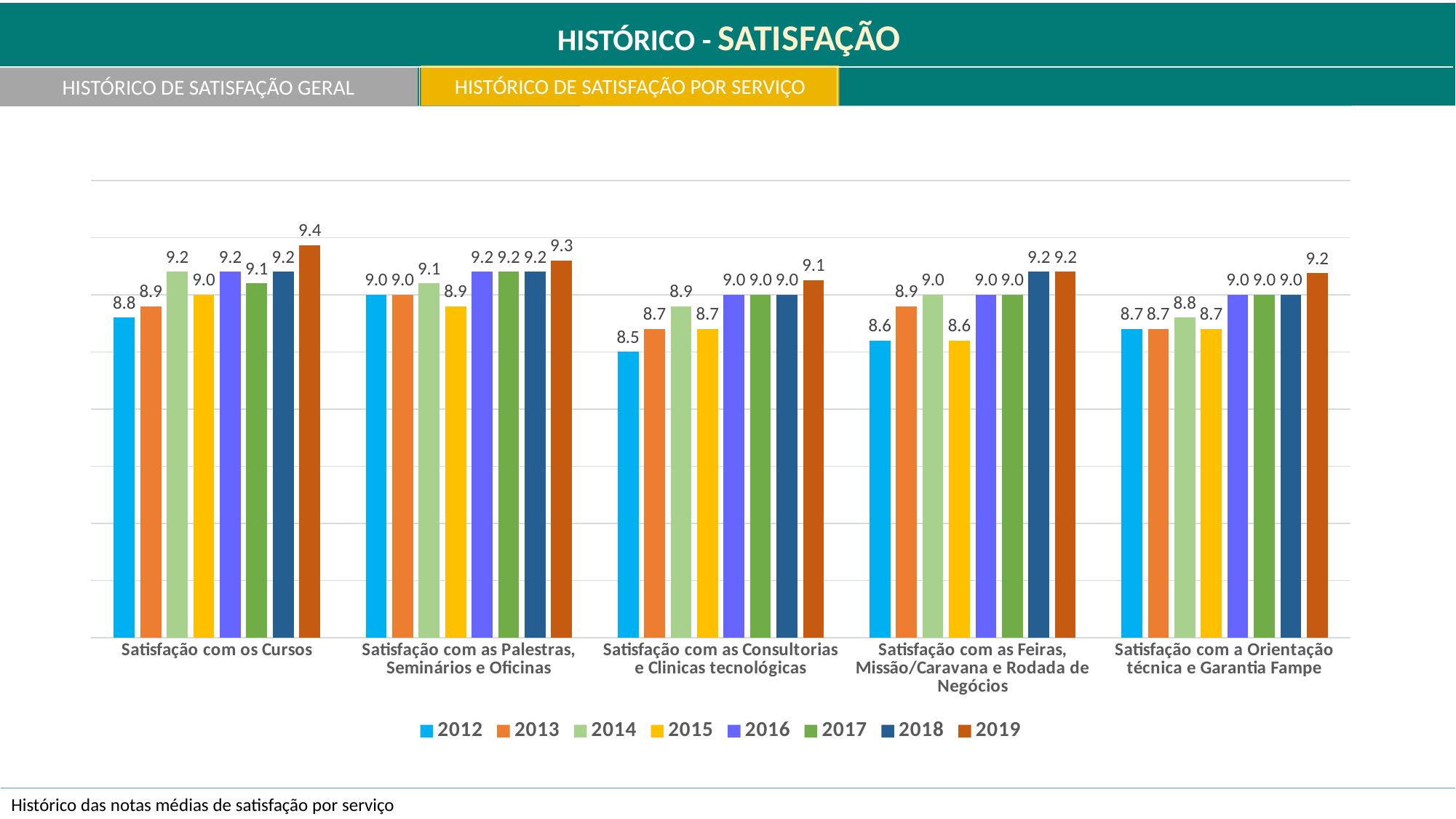
What is the 2019 value for Satisfação com os Cursos? 9.4 What is the 2014 value for Satisfação com a Orientação técnica e Garantia Fampe? 8.8 Which year is shown in the legend with a yellow colour? 2015 Which is larger for 2013: Satisfação com as Feiras, Missão/Caravana e Rodada de Negócios or Satisfação com a Orientação técnica e Garantia Fampe? Satisfação com as Feiras, Missão/Caravana e Rodada de Negócios What is the 2015 value for Satisfação com as Feiras, Missão/Caravana e Rodada de Negócios? 8.6 What is the 2012 value for Satisfação com as Consultorias e Clinicas tecnológicas? 8.5 Which year has the highest value for Satisfação com as Palestras, Seminários e Oficinas? 2019 How many service categories are shown on the x axis? 5 Which year has the lowest value for Satisfação com as Consultorias e Clinicas tecnológicas? 2012 What type of chart is shown on the slide? bar chart How many series does the legend list? 8 What is the difference between the 2019 and 2012 values for Satisfação com os Cursos? 0.6